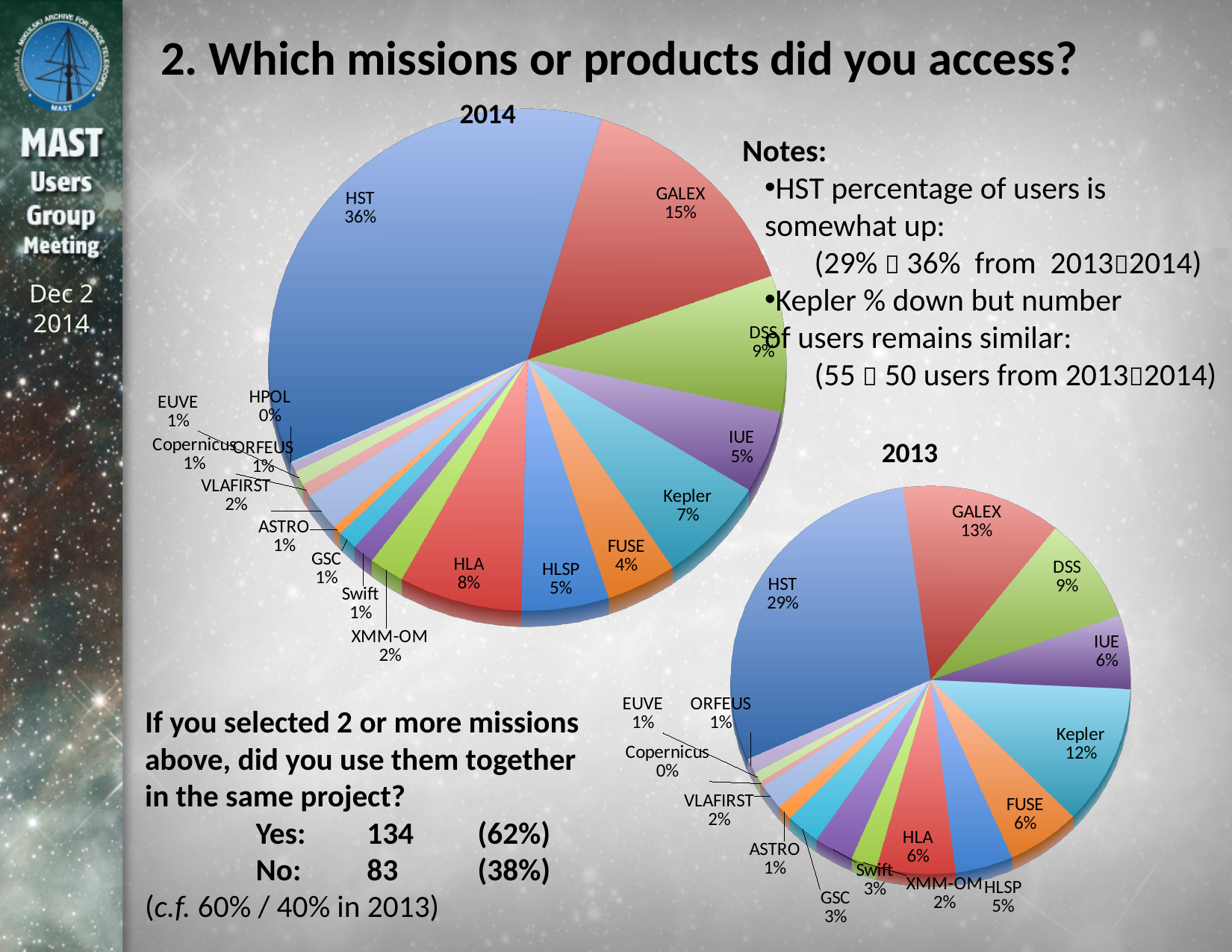
What is the difference between the HST share in 2014 and the HST share in 2013? 7% In the 2014 pie chart, what percentage is shown for DSS? 9% In the 2014 pie chart, which mission is labelled with 0%? HPOL What kind of chart is used to show the 2014 data? Pie chart In the 2013 pie chart, what percentage is shown for Kepler? 12% In the 2014 pie chart, what percentage is shown for HST? 36% In the 2013 pie chart, which mission has the largest share? HST What are the titles of the two pie charts on the slide? 2014 and 2013 In the 2013 pie chart, what percentage is shown for FUSE? 6% In the 2014 pie chart, which is larger, the share for HLA or the share for Kepler? HLA In the 2014 pie chart, what percentage is shown for GALEX? 15% In the 2013 pie chart, which is larger, the share for Kepler or the share for GALEX? GALEX